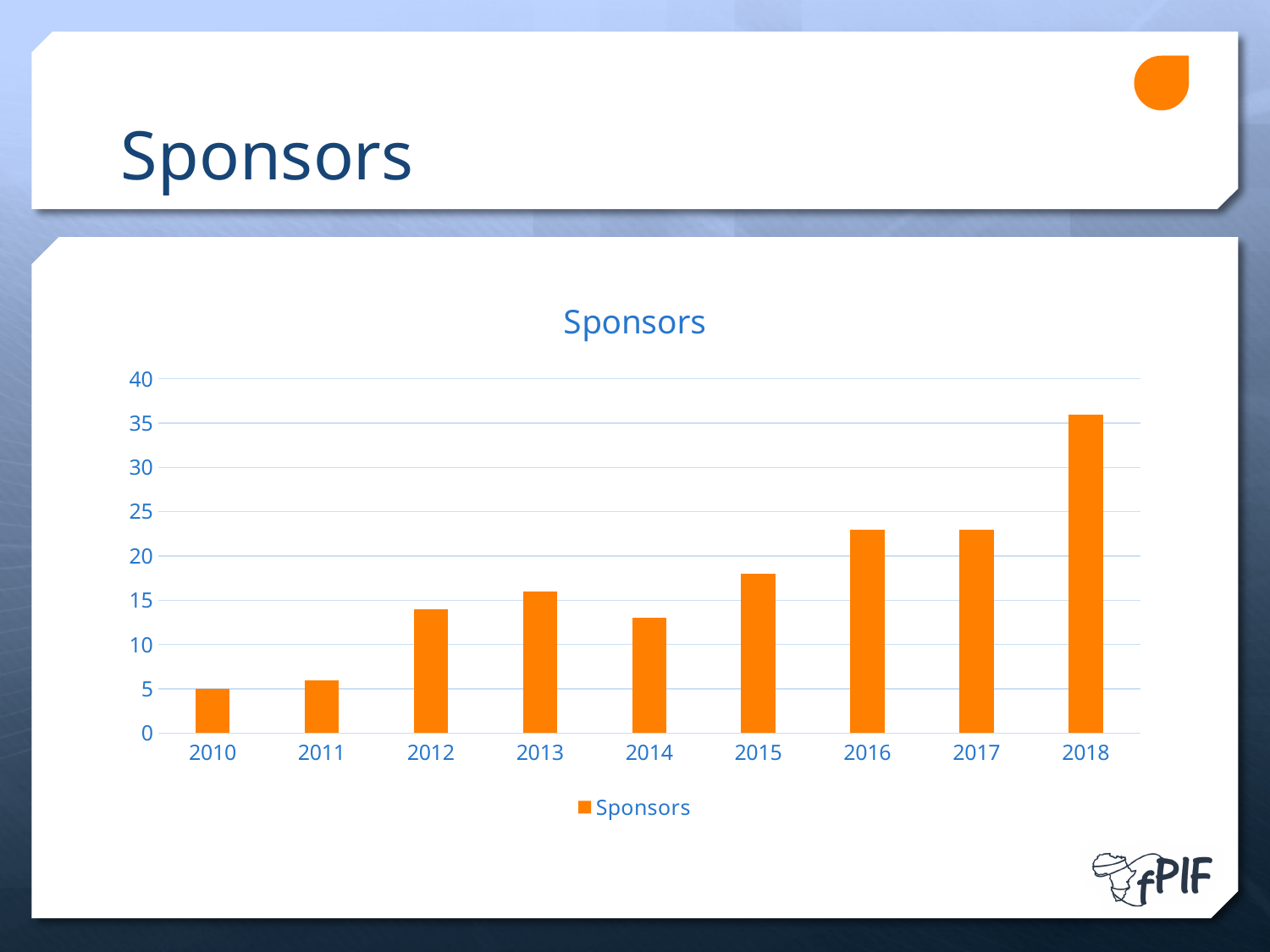
How many years are shown on the x axis of the chart? 9 How many series does the legend list? 1 Which year has the lowest number of sponsors? 2010 What is the value for 2010? 5 Do the values generally rise or fall from 2010 to 2018? rise Is the value for 2014 greater or less than 15? less What is the title of the chart? Sponsors Is the value for 2016 greater or less than 20? greater Which year has the highest number of sponsors? 2018 What type of chart is shown on the slide? bar chart Which is larger, the value for 2015 or the value for 2013? 2015